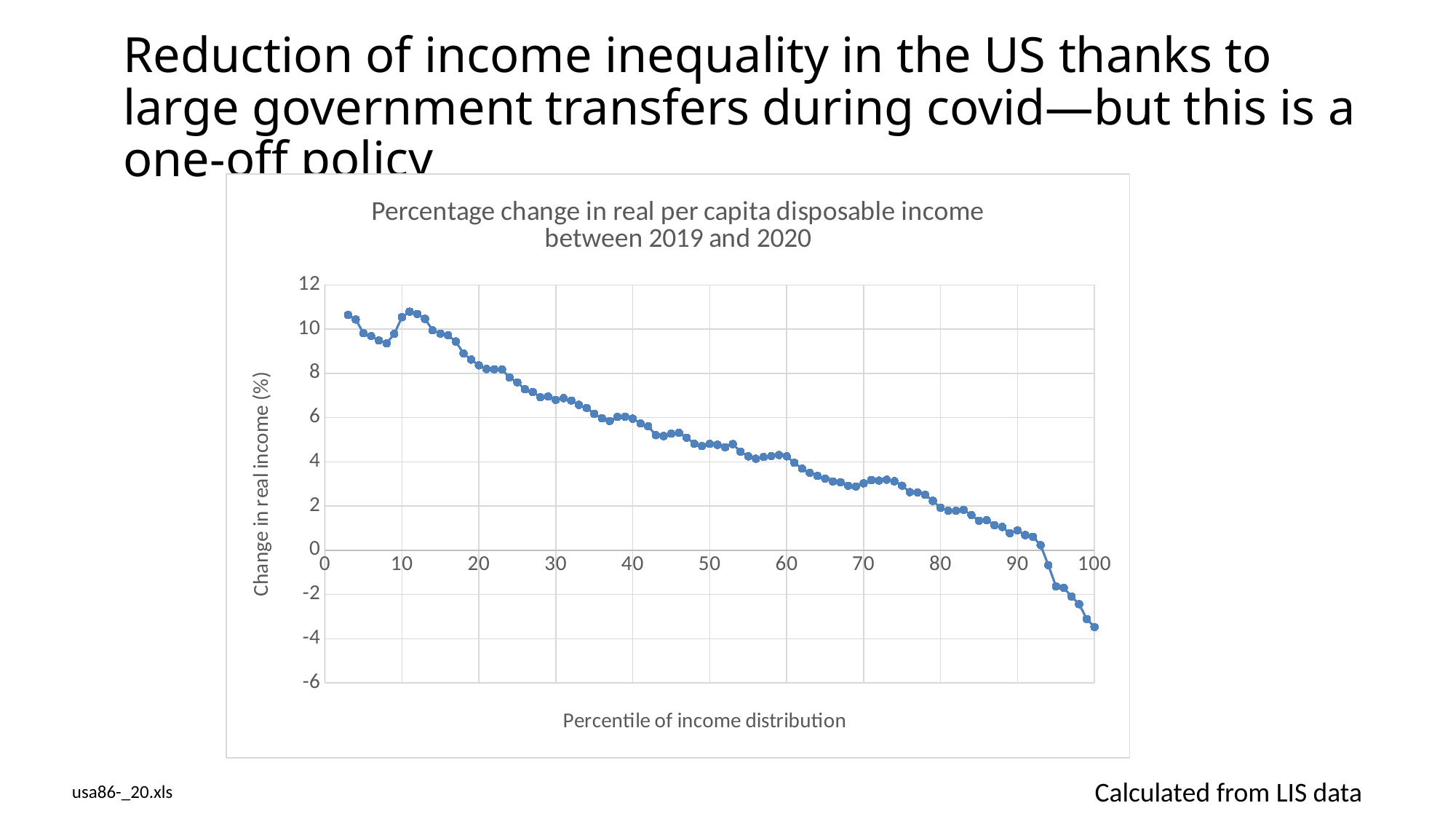
Is the value at percentile 20 greater or less than 8? greater Which has the larger value, percentile 40 or percentile 60? percentile 40 Is the value at percentile 50 greater or less than 4? greater Is the value at percentile 100 greater or less than -2? less What is the title of the chart? Percentage change in real per capita disposable income between 2019 and 2020 What is the label of the x axis of the chart? Percentile of income distribution Do the values generally rise or fall as the percentile of income distribution increases? fall What kind of chart is shown on the slide? line chart At which end of the income distribution is the change in real income lowest, the bottom percentiles or the top percentiles? the top percentiles